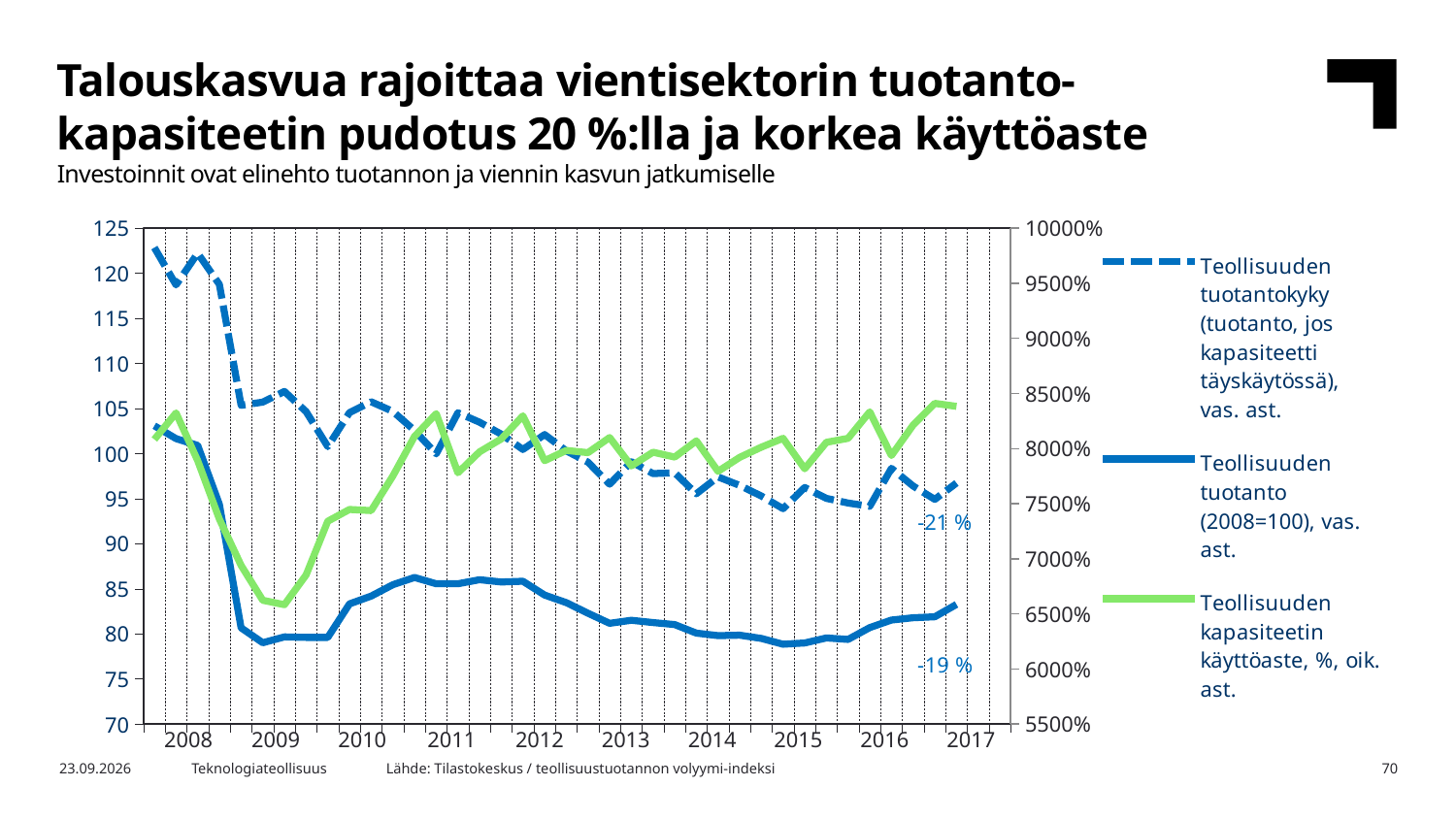
In 2017, which is higher: Teollisuuden tuotantokyky or Teollisuuden tuotanto (2008=100)? Teollisuuden tuotantokyky Is the value of Teollisuuden tuotantokyky at the end of the series in 2017 greater or less than 90? greater Which year is the first labelled on the x axis? 2008 Is the value of Teollisuuden tuotanto (2008=100) at the end of the series in 2017 greater or less than 90? less Does Teollisuuden tuotantokyky rise or fall overall from 2008 to 2017? fall What kind of chart is shown on the slide? Line chart Is the value of Teollisuuden tuotantokyky at the start of 2008 greater or less than 120? greater Does Teollisuuden tuotanto (2008=100) rise or fall between 2008 and 2009? fall How many years are labelled on the x axis? 10 How many series does the legend list? 3 What percentage change annotation is printed near the end of the Teollisuuden tuotanto (2008=100) line? -19 %